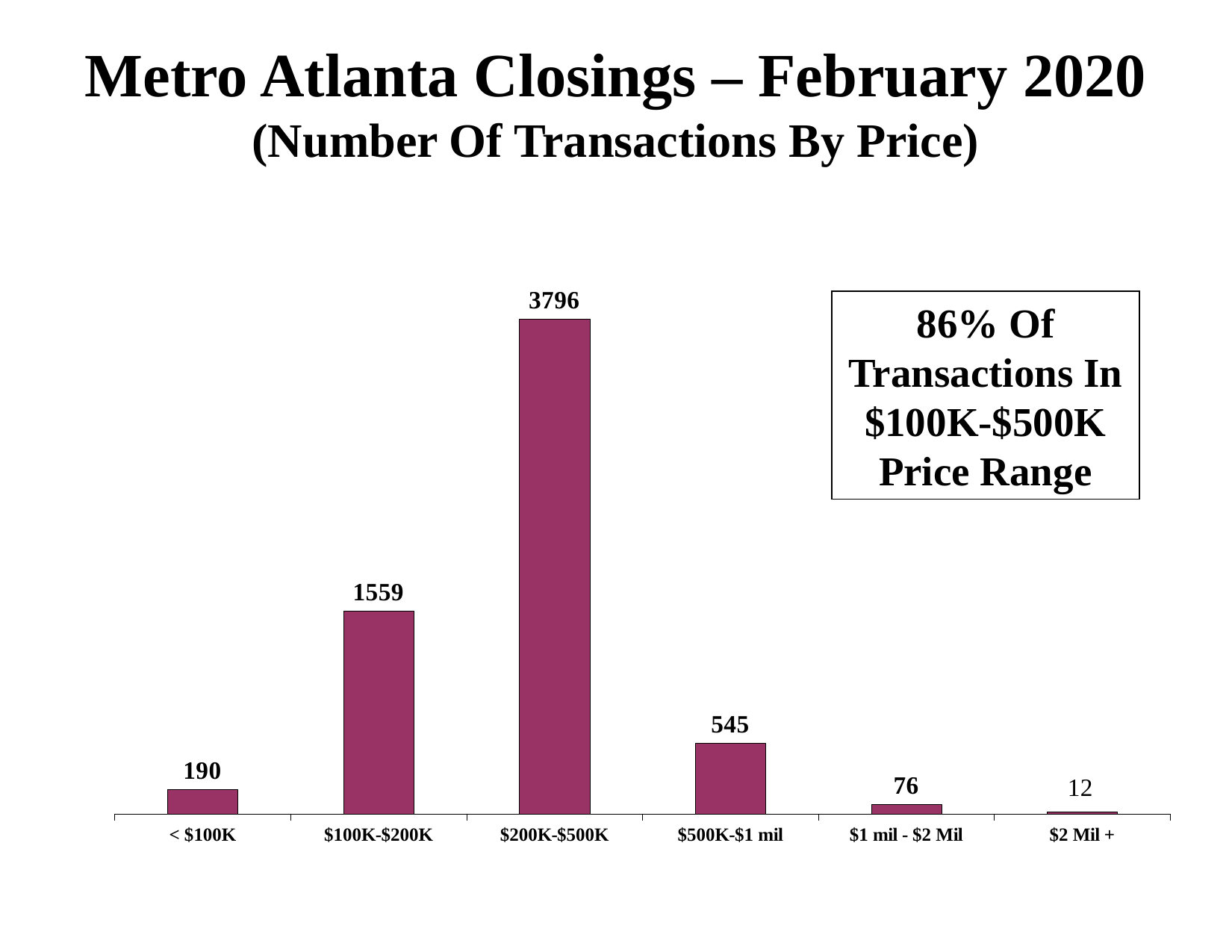
How many transactions were in the $200K-$500K price range? 3796 How many price range categories are shown on the chart? 6 Which price range had the highest number of transactions? $200K-$500K How many transactions were in the $1 mil - $2 Mil price range? 76 Which price range had the lowest number of transactions? $2 Mil + How many transactions were in the < $100K price range? 190 What is the difference in transactions between the $500K-$1 mil and < $100K price ranges? 355 What type of chart is shown on the slide? Bar chart According to the text box on the slide, what percentage of transactions were in the $100K-$500K price range? 86% How many transactions were in the $2 Mil + price range? 12 Which price range had more transactions, $100K-$200K or $500K-$1 mil? $100K-$200K What is the difference in transactions between the $200K-$500K and $100K-$200K price ranges? 2237